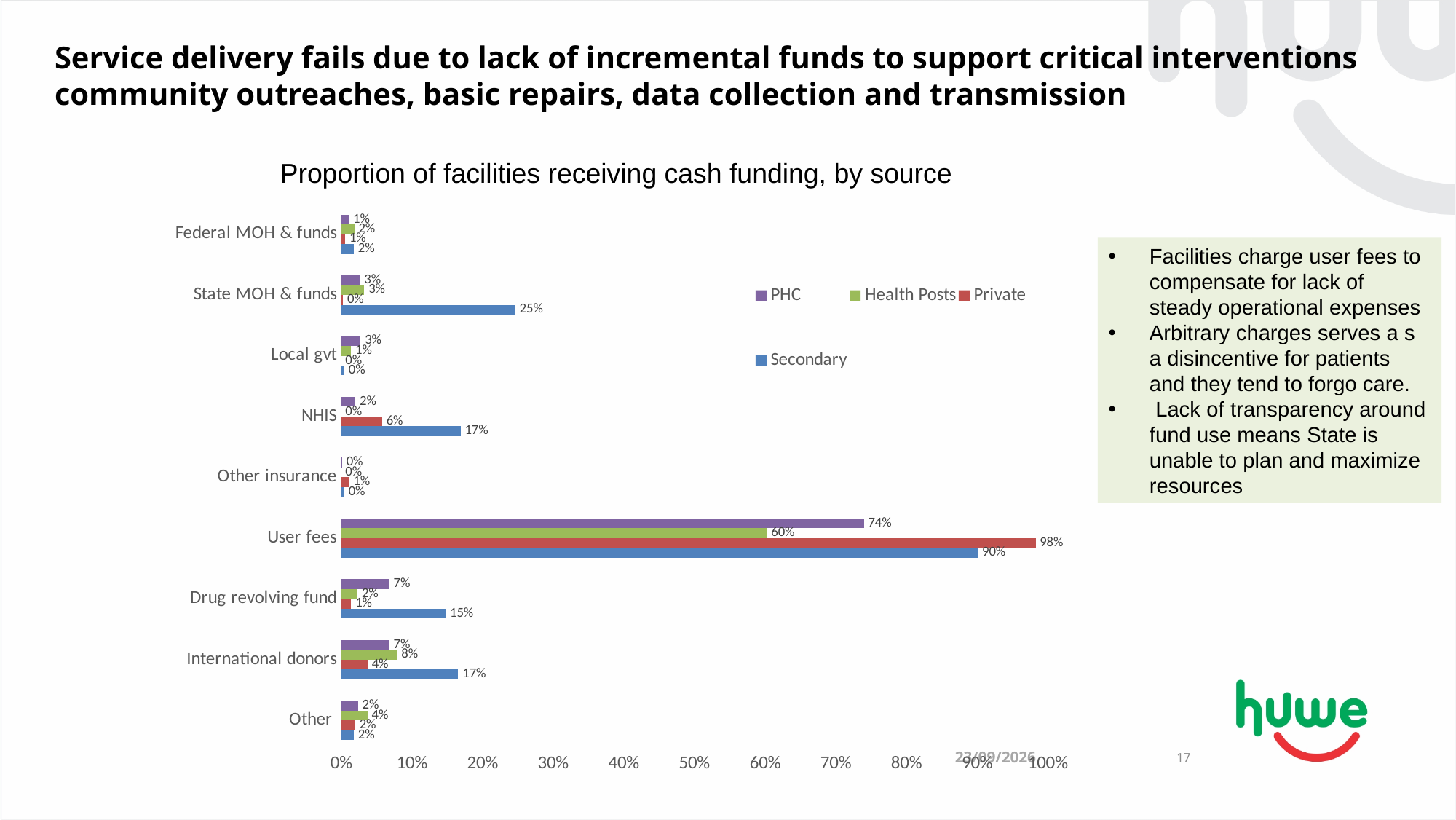
Which series has the lowest value under User fees? Health Posts What is the value for Private facilities under User fees? 98% Under NHIS, which is larger: the Secondary value or the Private value? Secondary What is the difference between the Private and Health Posts values under User fees? 38% What is the difference between the Secondary and PHC values under Drug revolving fund? 8% What is the value for Secondary facilities under State MOH & funds? 25% What type of chart is shown on the slide? Bar chart What is the value for Health Posts under International donors? 8% What is the title of the chart? Proportion of facilities receiving cash funding, by source How many series does the chart legend list? 4 How many funding source categories are shown on the chart? 9 Which funding source has the highest value for PHC facilities? User fees